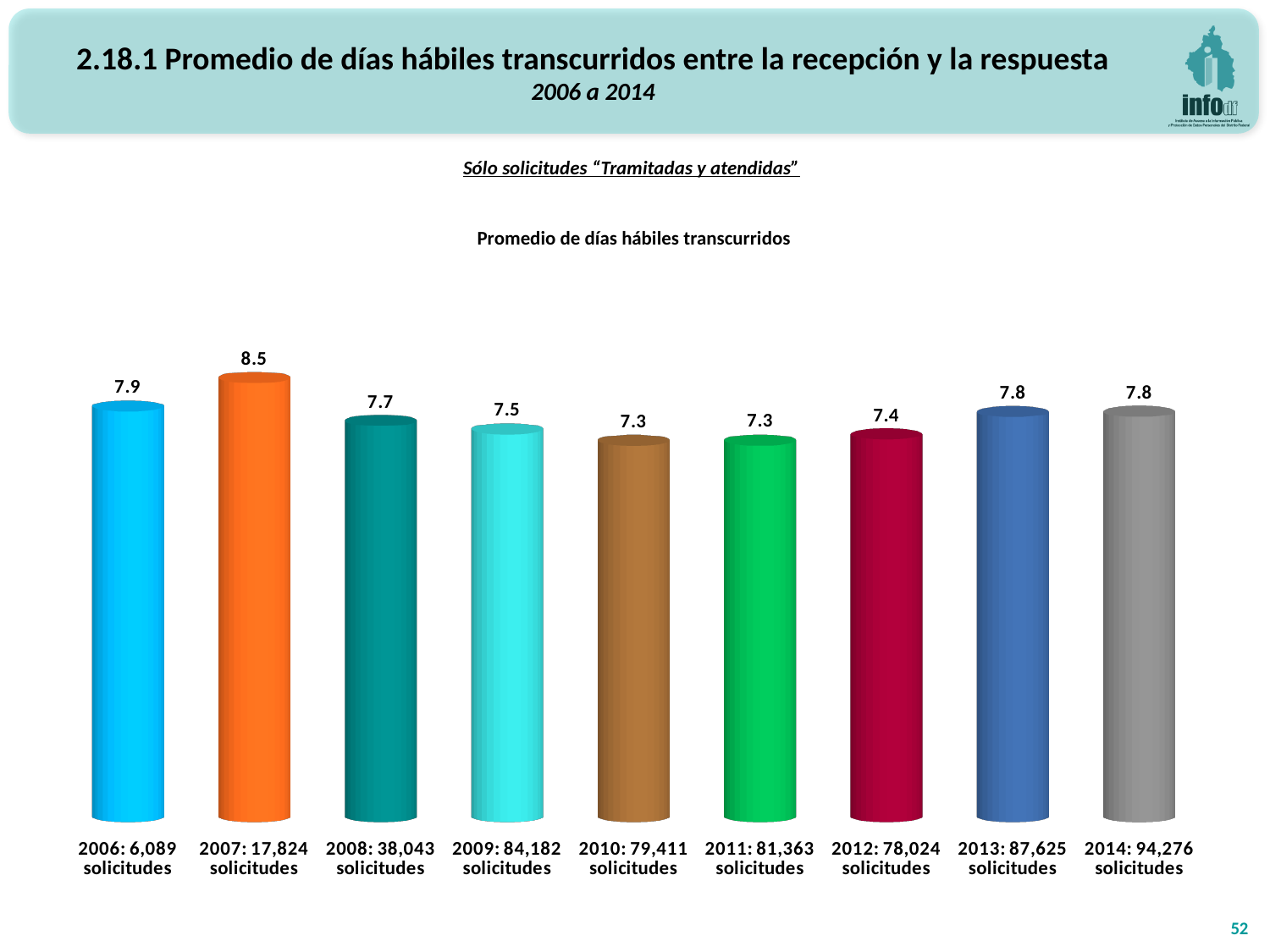
What is the average number of business days for 2012? 7.4 What kind of chart is shown on the slide? bar chart What is the difference between the 2006 value and the 2009 value? 0.4 What is the average number of business days for 2007? 8.5 How many solicitudes are listed in the label for 2014? 94,276 What is the difference between the 2007 value and the 2011 value? 1.2 Which is larger, the value for 2012 or the value for 2013? 2013 Which is larger, the value for 2006 or the value for 2008? 2006 Do the values rise or fall from 2007 to 2010? fall What is the average number of business days for 2014? 7.8 How many years are shown in the chart? 9 Which year has the highest average number of business days? 2007